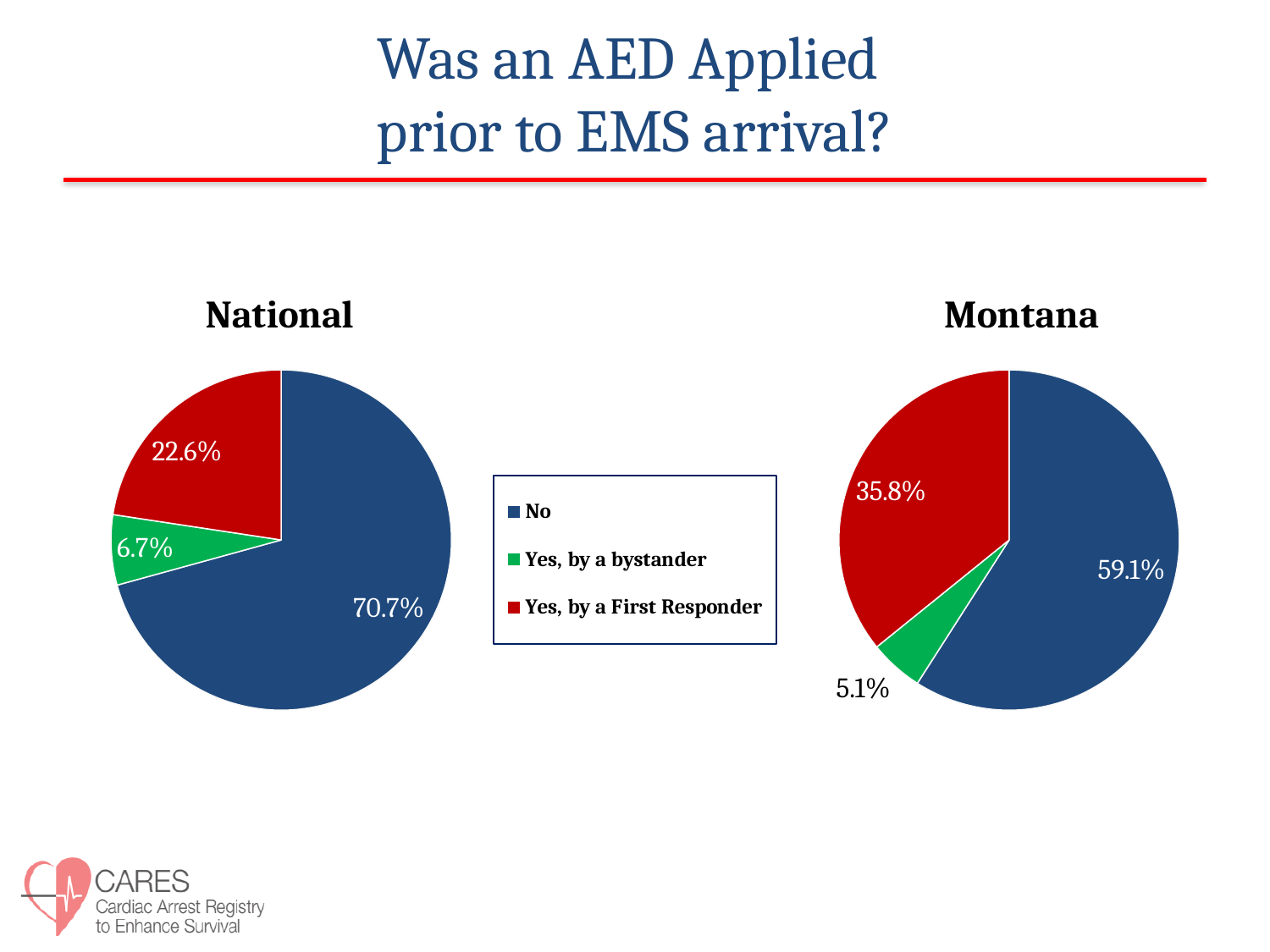
In the National pie chart, which category has the largest share? No In the National pie chart, what percentage is shown for "No"? 70.7% Which is larger: the "No" share in the National chart or the "No" share in the Montana chart? National In the National pie chart, what is the combined share of the two "Yes" categories? 29.3% How many entries does the legend list? 3 What type of chart is used for the National data? Pie chart In the Montana pie chart, what percentage is shown for "Yes, by a bystander"? 5.1% What colour represents "Yes, by a bystander" in the legend? Green In the Montana pie chart, what percentage is shown for "Yes, by a First Responder"? 35.8% What is the difference between the "Yes, by a First Responder" share in the Montana chart and in the National chart? 13.2% How many slices does the Montana pie chart have? 3 In the Montana pie chart, which category has the smallest share? Yes, by a bystander